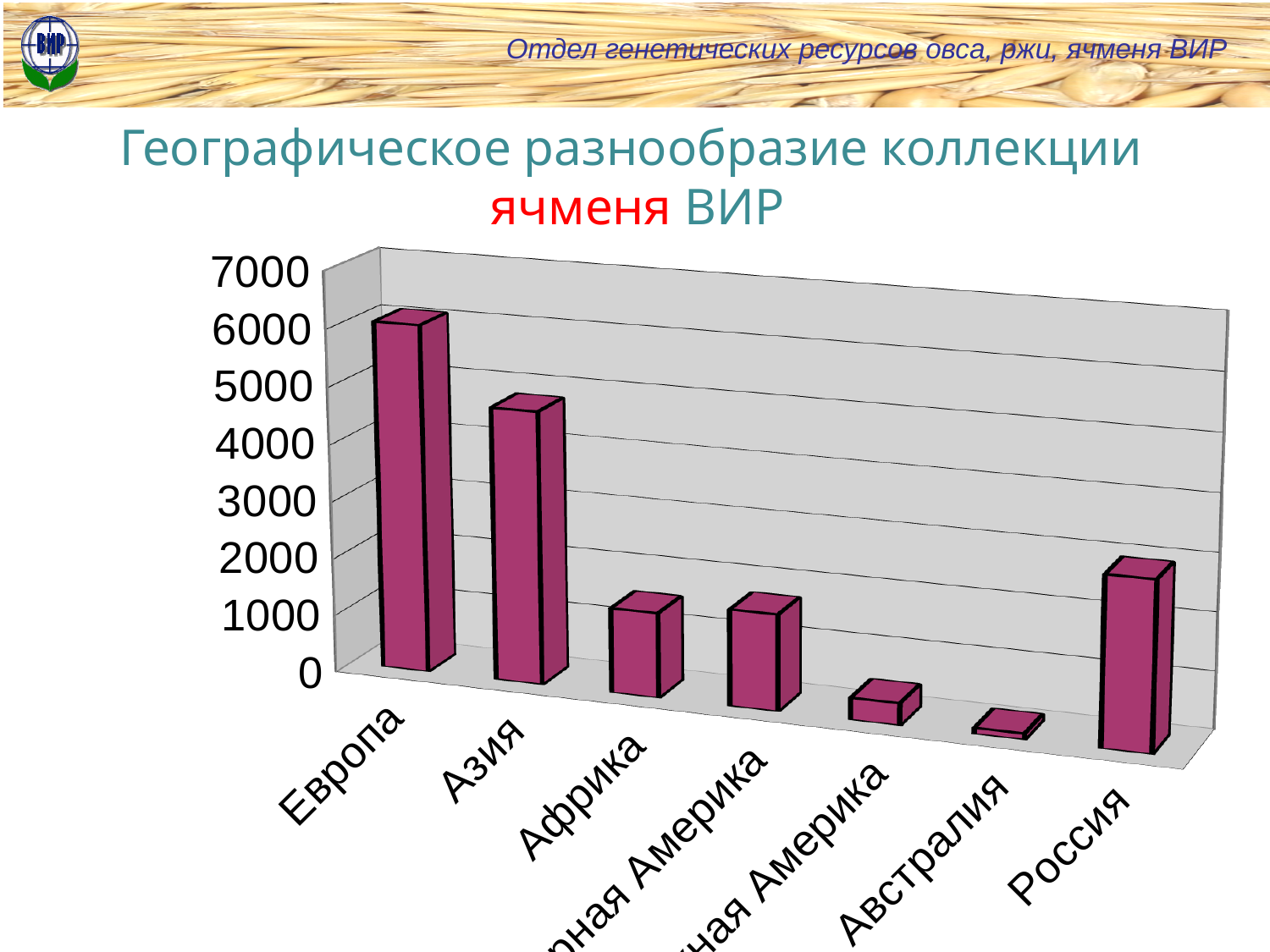
Is the value for Австралия greater or less than 1000? less Is the value for Россия greater or less than 3000? less What is the title of the chart on the slide? Географическое разнообразие коллекции ячменя ВИР Which is larger, the value for Европа or the value for Азия? Европа Which category has the highest bar in the chart? Европа What kind of chart is shown on the slide? bar chart Which is larger, the value for Россия or the value for Африка? Россия Which category has the lowest bar in the chart? Австралия How many categories are shown on the x axis of the chart? 7 Is the value for Европа greater or less than 5000? greater What is the highest value shown on the vertical axis of the chart? 7000